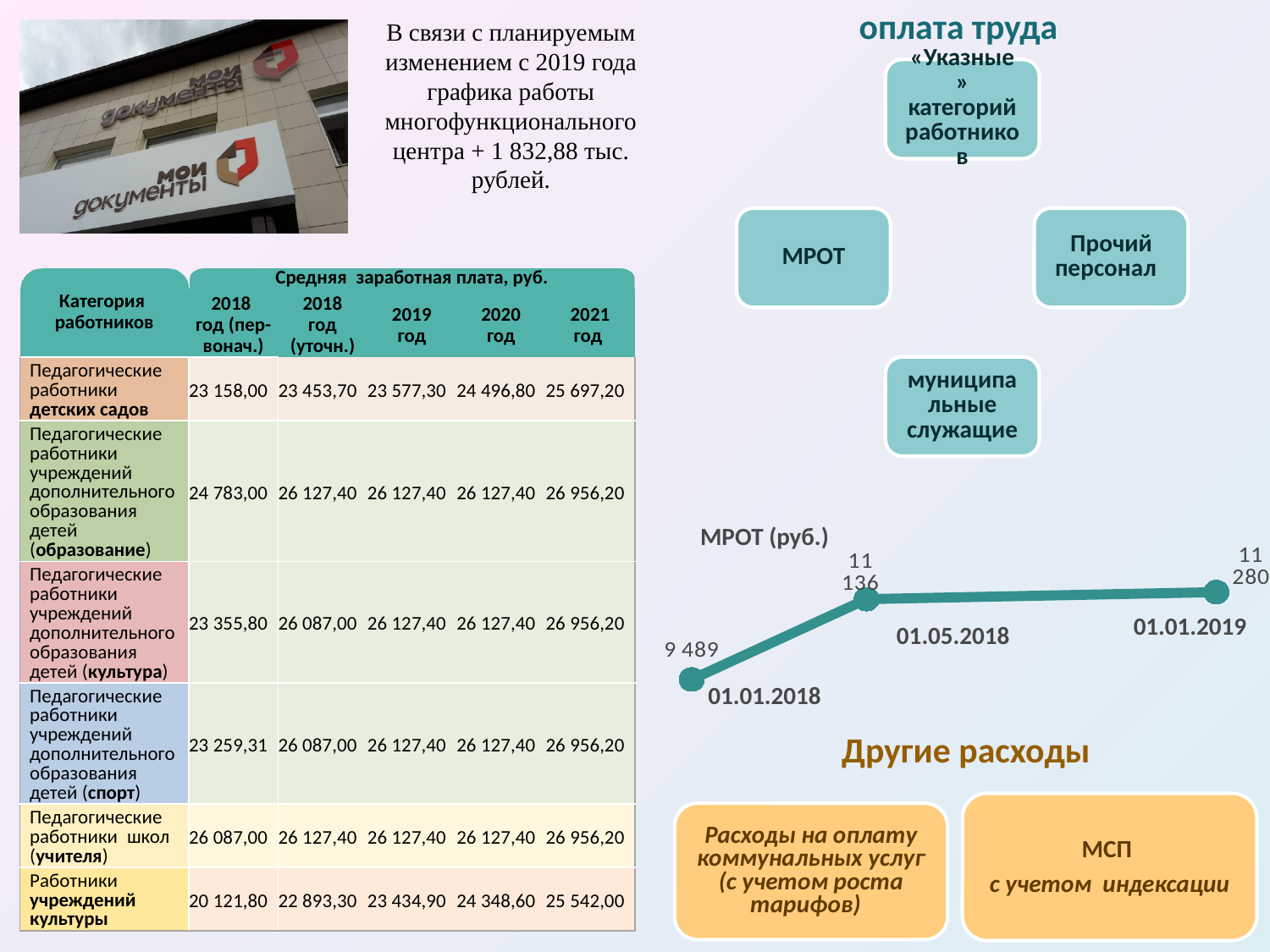
In the "МРОТ (руб.)" chart, what is the value for 01.01.2019? 11 280 In the "МРОТ (руб.)" chart, what is the value for 01.01.2018? 9 489 In the "МРОТ (руб.)" chart, what is the difference between the values for 01.05.2018 and 01.01.2018? 1 647 How many data points are plotted in the "МРОТ (руб.)" chart? 3 In the "МРОТ (руб.)" chart, what is the value for 01.05.2018? 11 136 In the "МРОТ (руб.)" chart, do the values rise or fall from 01.01.2018 to 01.01.2019? rise What is the title of the line chart on the slide? МРОТ (руб.) In the "МРОТ (руб.)" chart, what is the difference between the values for 01.01.2019 and 01.05.2018? 144 What kind of chart is the "МРОТ (руб.)" chart? line chart In the "МРОТ (руб.)" chart, which date has the highest value? 01.01.2019 In the "МРОТ (руб.)" chart, which is larger: the value for 01.01.2018 or the value for 01.05.2018? 01.05.2018 In the "МРОТ (руб.)" chart, which date has the lowest value? 01.01.2018